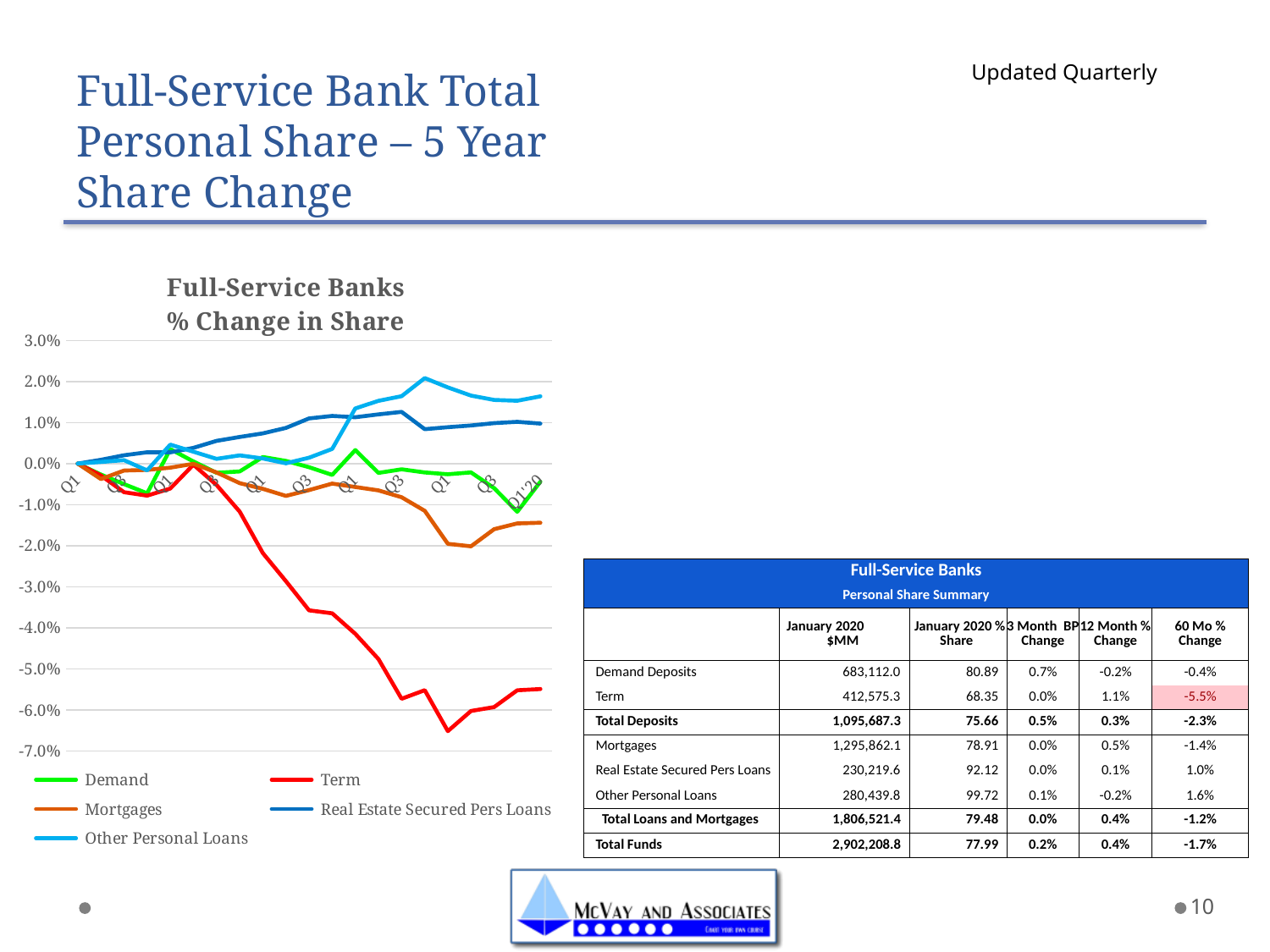
Which series has the lowest value at the right end of the line chart? Term Which colour is used for the Term series in the line chart? red Is the final value of the Term series greater or less than -5.0%? less Does the Term series generally rise or fall across the x axis of the line chart? fall What is the title of the line chart? Full-Service Banks % Change in Share Is the final value of the Mortgages series greater or less than -1.0%? less At the right end of the line chart, which is larger: the Term value or the Mortgages value? Mortgages At the right end of the line chart, which is larger: the Other Personal Loans value or the Demand value? Other Personal Loans What kind of chart is shown on the slide? line chart How many series does the legend of the line chart list? 5 Which series has the highest value at the right end of the line chart? Other Personal Loans Is the final value of the Other Personal Loans series greater or less than 1.0%? greater